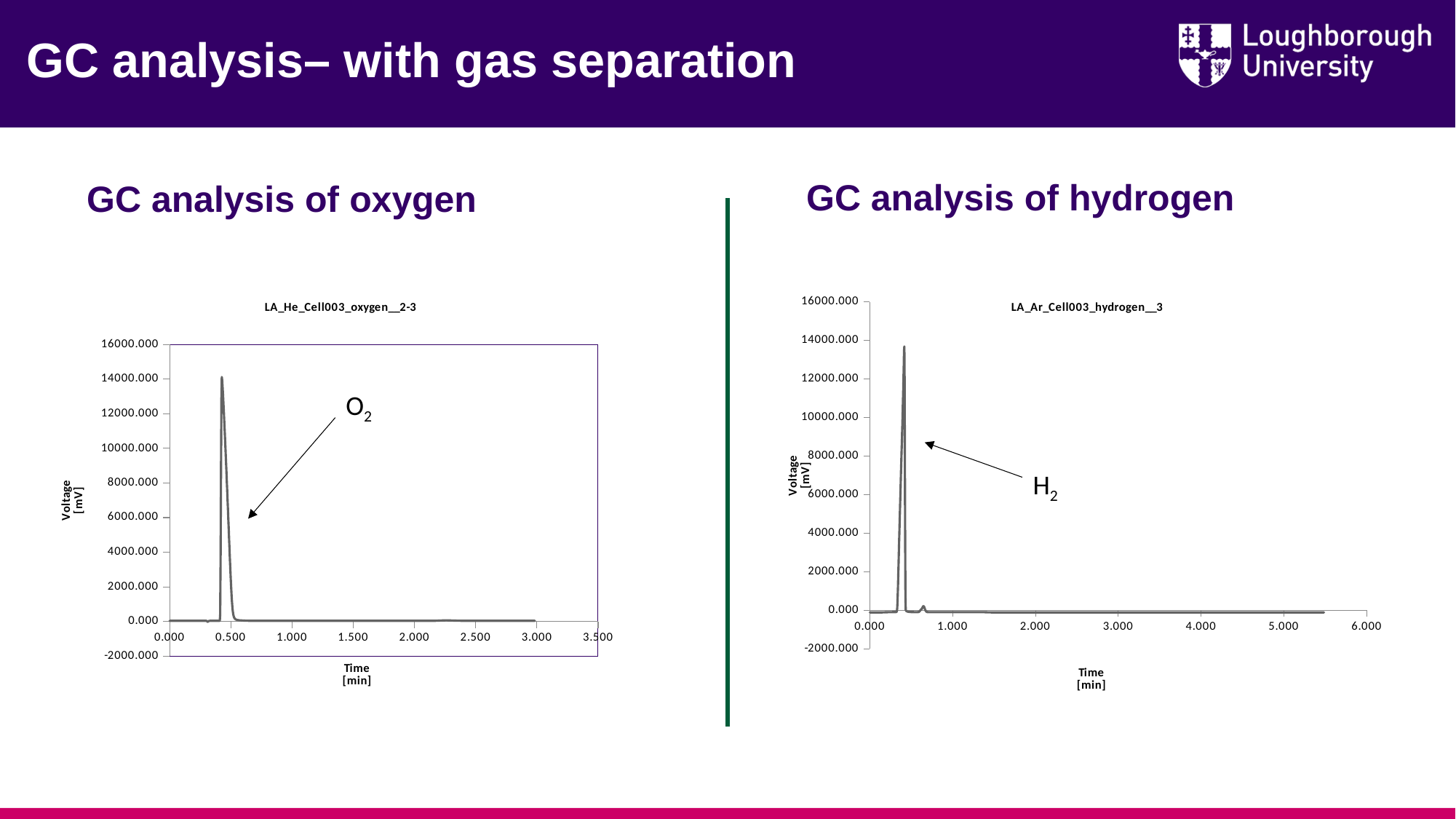
In the right chart (GC analysis of hydrogen), is the peak voltage greater or less than 12000.000 mV? greater What kind of chart is the 'GC analysis of oxygen' chart on the left? line chart What is the maximum value shown on the x axis of the left chart (GC analysis of oxygen)? 3.500 What is the maximum value shown on the x axis of the right chart (GC analysis of hydrogen)? 6.000 How many charts are shown on the slide? 2 In the left chart (GC analysis of oxygen), is the peak voltage greater or less than 12000.000 mV? greater What is the title printed inside the left chart (GC analysis of oxygen)? LA_He_Cell003_oxygen__2-3 In the left chart (GC analysis of oxygen), does the O2 peak occur at a time greater or less than 1.000 min? less What is the title printed inside the right chart (GC analysis of hydrogen)? LA_Ar_Cell003_hydrogen__3 What kind of chart is the 'GC analysis of hydrogen' chart on the right? line chart